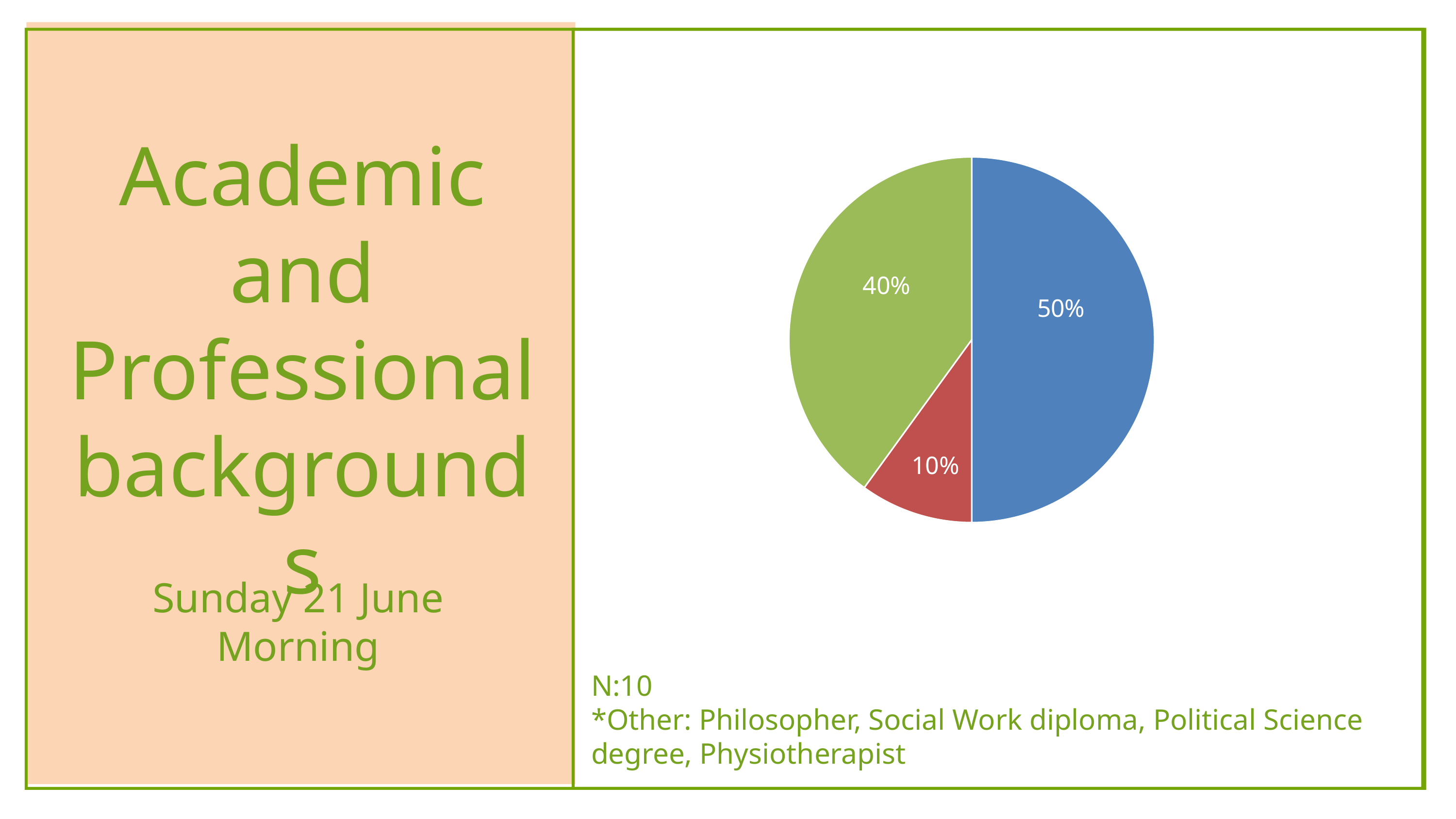
What is the difference in percentage points between the green slice and the red slice? 30 What is the difference in percentage points between the blue slice and the green slice? 10 What share of the pie does the blue slice represent? 50% Which colour slice is the largest in the pie chart? blue Does the pie chart display a legend? No How many slices does the pie chart have? 3 What percentage is shown on the blue slice of the pie chart? 50% Which is larger, the green slice or the red slice? green What percentage is shown on the green slice of the pie chart? 40% Which colour slice is the smallest in the pie chart? red What percentage is shown on the red slice of the pie chart? 10% What kind of chart is shown on the slide? pie chart